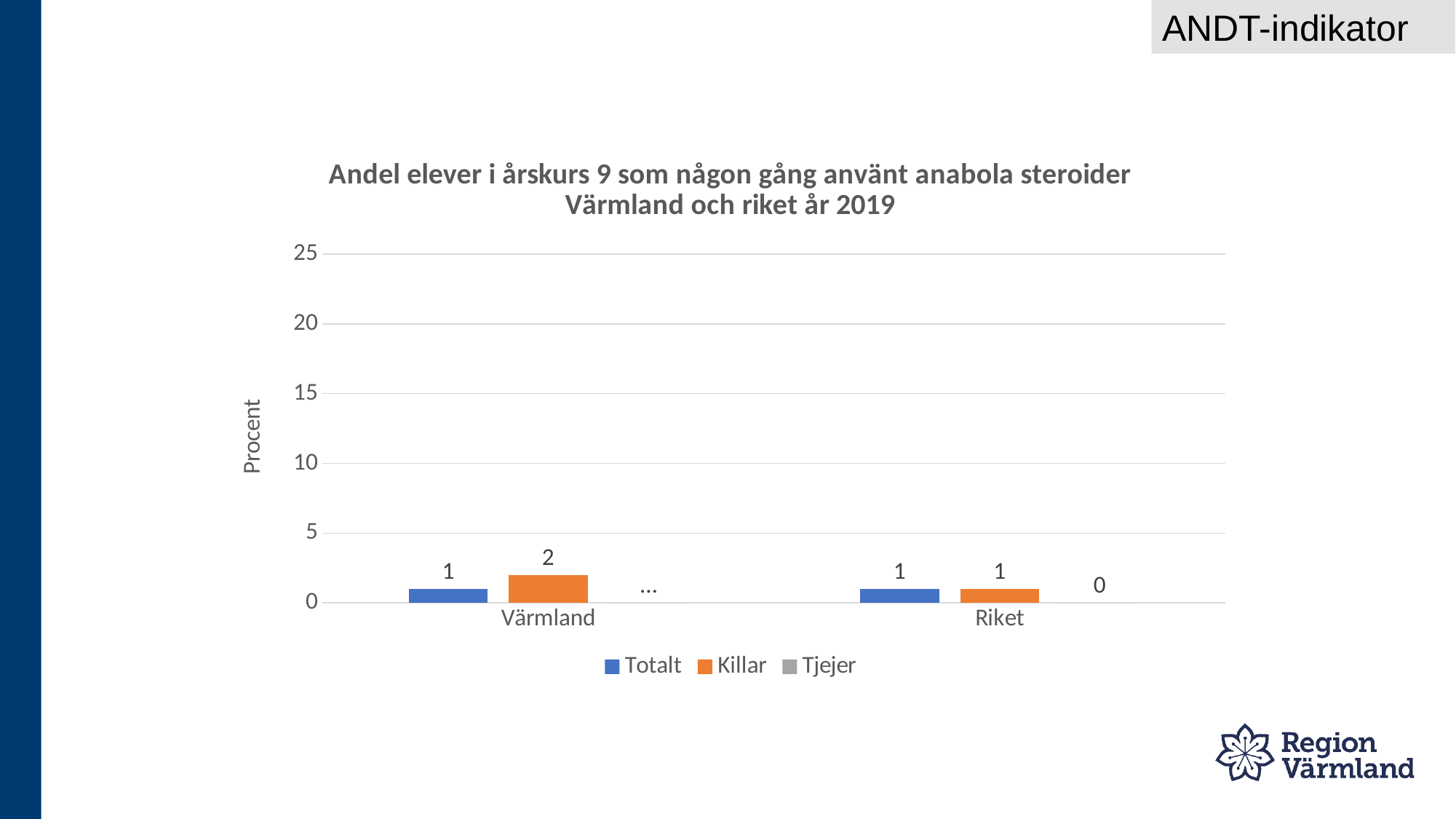
What is the difference between the Killar value in Värmland and the Killar value in Riket? 1 What type of chart is shown on the slide? bar chart Is the Killar value in Värmland larger or smaller than the Killar value in Riket? larger Which series has the highest value in Värmland? Killar What is the value for Totalt in Värmland? 1 What is the value for Killar in Värmland? 2 What is the value for Tjejer in Riket? 0 What is the value for Killar in Riket? 1 How many categories are shown on the x axis? 2 What is the label of the y axis? Procent How many series does the legend list? 3 What is the value for Totalt in Riket? 1